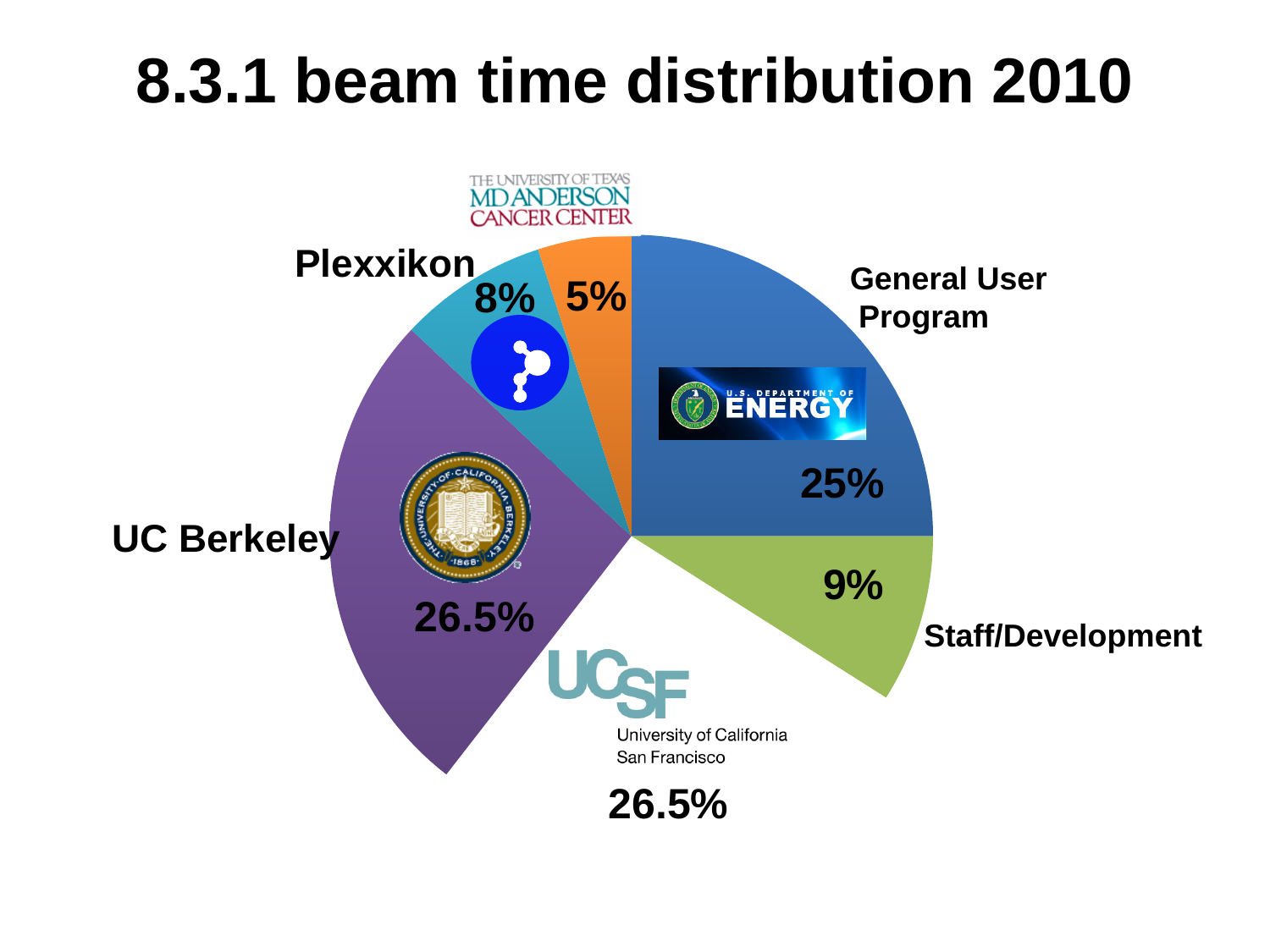
What percentage of beam time went to the General User Program? 25% How many categories are shown in the pie chart? 6 What percentage of beam time went to Staff/Development? 9% What is the difference between the General User Program share and the Staff/Development share? 16% What is the title of the chart? 8.3.1 beam time distribution 2010 What type of chart is shown on the slide? pie chart What percentage of beam time went to the University of Texas MD Anderson Cancer Center? 5% What is the combined share of UC Berkeley and UCSF? 53% What percentage of beam time went to UC Berkeley? 26.5% Which has a larger share of beam time, Plexxikon or Staff/Development? Staff/Development What percentage of beam time went to Plexxikon? 8% Which category has the smallest share of beam time? MD Anderson Cancer Center